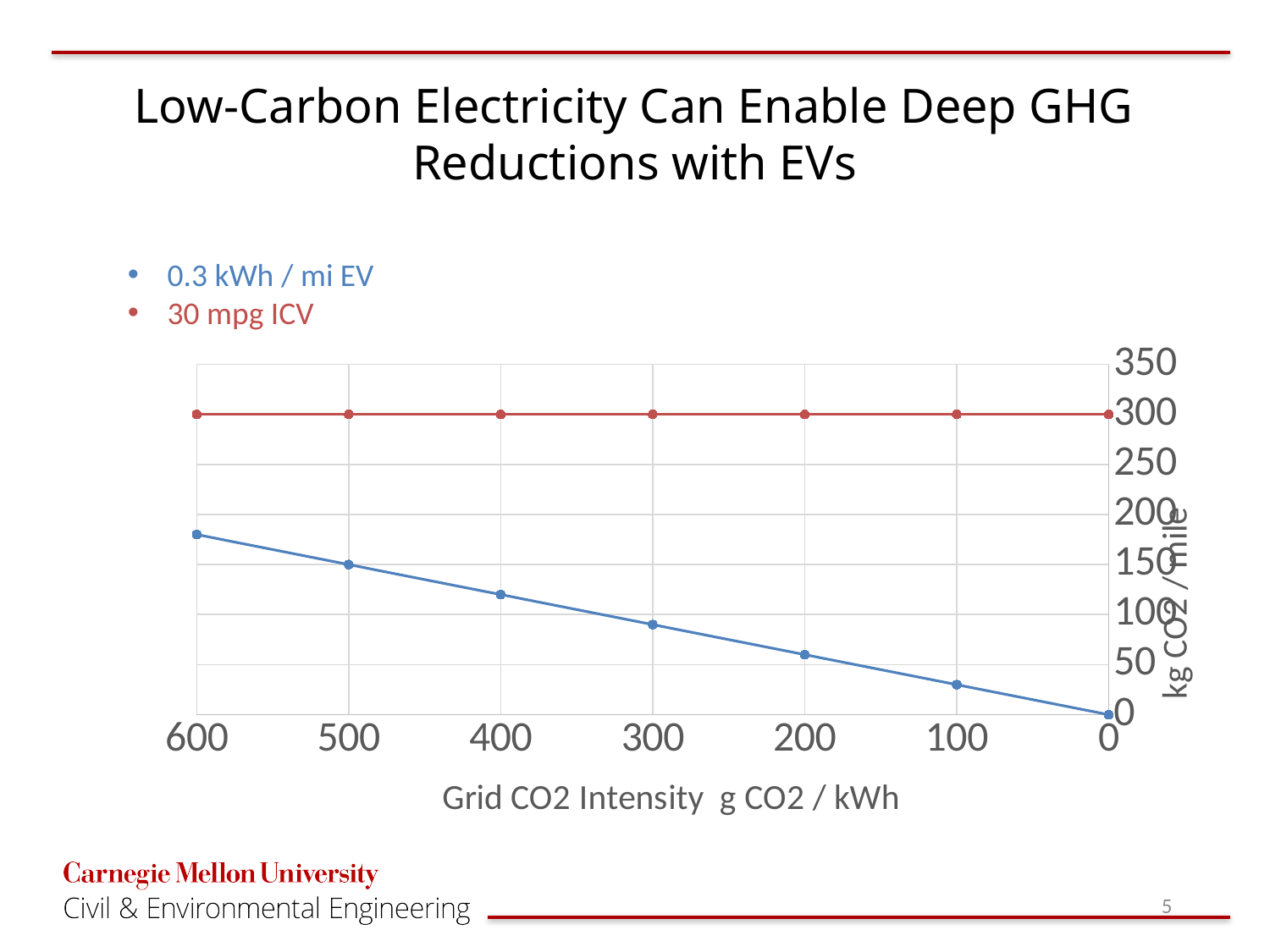
What is the value of the 30 mpg ICV line (red) at a grid CO2 intensity of 500 g CO2 / kWh? 300 What is the value of the 0.3 kWh / mi EV line (blue) at a grid CO2 intensity of 0 g CO2 / kWh? 0 What is the title of the x axis? Grid CO2 Intensity g CO2 / kWh What kind of chart is shown on the slide? line chart Is the value of the EV line (blue) at a grid CO2 intensity of 200 greater or less than 50? greater How does the ICV line (red) change across the x axis? it stays flat How many data points does each line have? 7 What is the value of the 0.3 kWh / mi EV line (blue) at a grid CO2 intensity of 500 g CO2 / kWh? 150 At a grid CO2 intensity of 400 g CO2 / kWh, which line is higher, the 0.3 kWh / mi EV or the 30 mpg ICV? 30 mpg ICV Is the value of the EV line (blue) at a grid CO2 intensity of 600 greater or less than 150? greater Is the value of the EV line (blue) at a grid CO2 intensity of 300 greater or less than 100? less How does the EV line (blue) change as grid CO2 intensity goes from 600 to 0 along the x axis? it falls